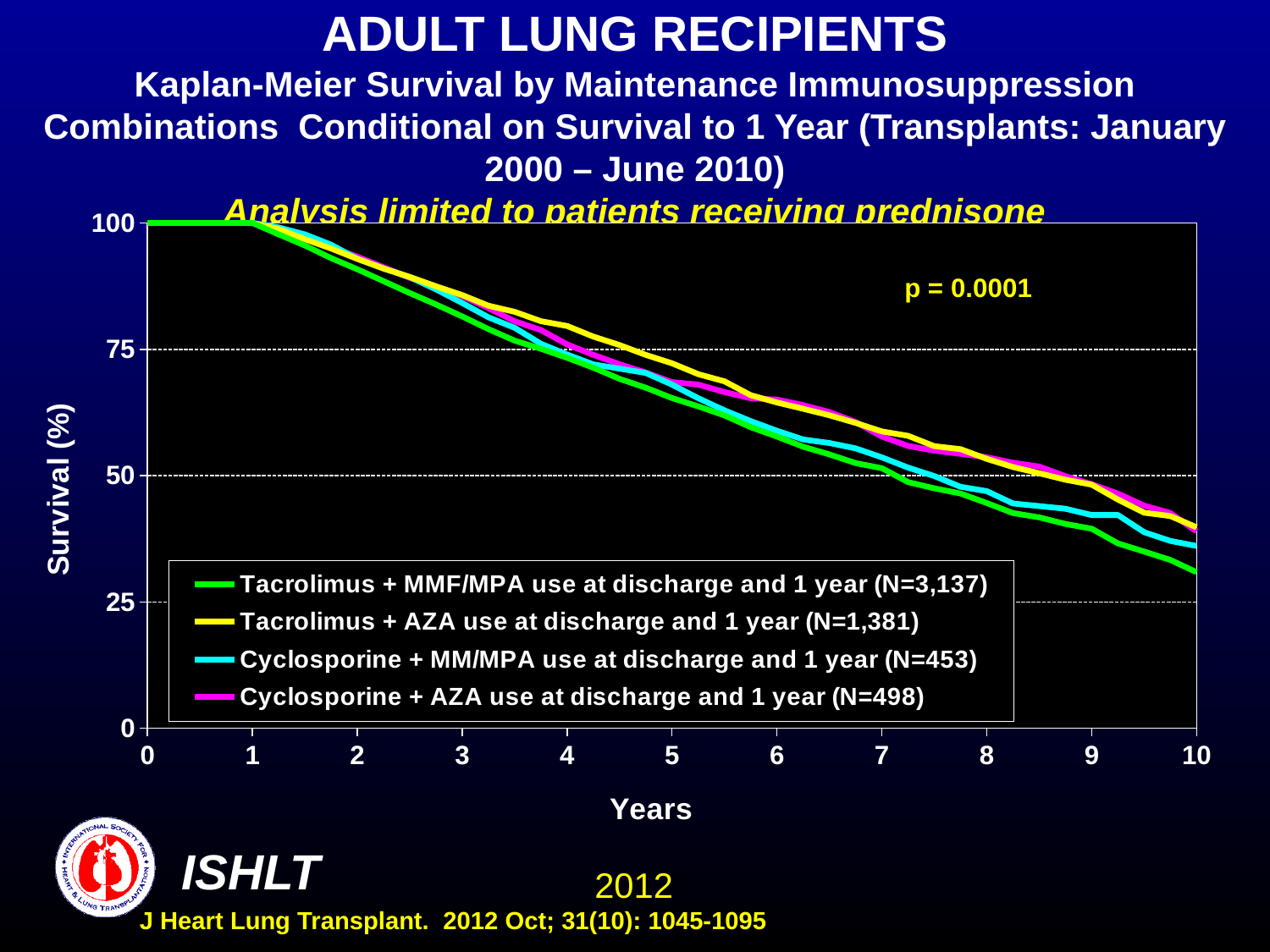
What p-value is shown on the chart? p = 0.0001 Is the survival for Tacrolimus + MMF/MPA at 10 years greater or less than 50? less Do the survival curves rise or fall as years since transplant increase? fall Is the survival for Tacrolimus + MMF/MPA at 10 years greater or less than 25? greater How many series does the legend list? 4 Is the survival for Cyclosporine + AZA at 3 years greater or less than 75? greater At 10 years, is survival higher for Tacrolimus + AZA or for Tacrolimus + MMF/MPA? Tacrolimus + AZA What is the N for the Tacrolimus + AZA series in the legend? 1,381 Which series has the lowest survival at 10 years? Tacrolimus + MMF/MPA use at discharge and 1 year (N=3,137) What kind of chart is shown on the slide? line chart